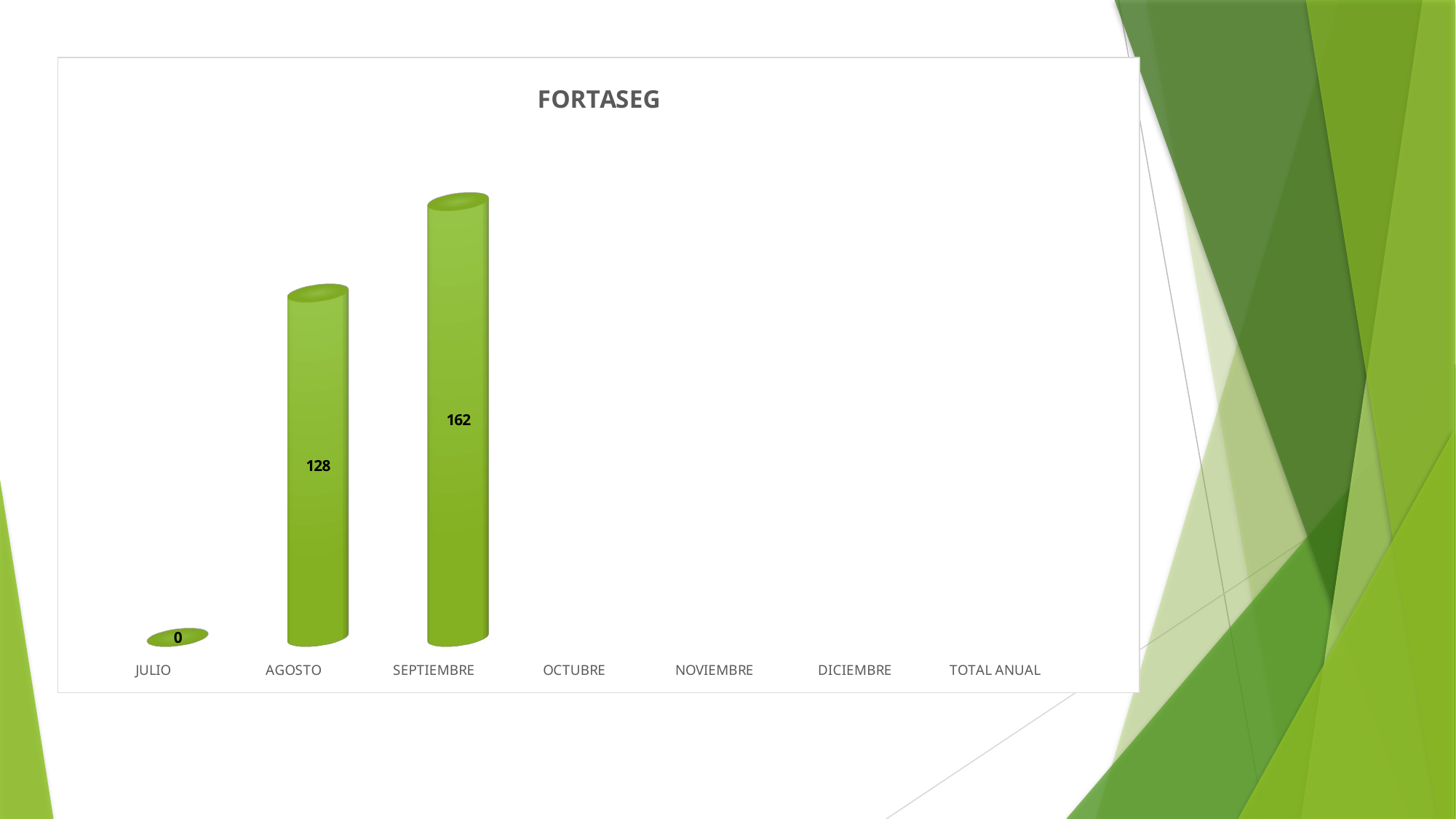
How many categories are shown on the x axis? 7 What colour are the bars in the chart? green Which category has the highest value? SEPTIEMBRE What is the label of the last category on the x axis? TOTAL ANUAL What is the value for AGOSTO? 128 What is the title of the chart? FORTASEG What is the value for JULIO? 0 What is the value for SEPTIEMBRE? 162 Which is larger, the value for AGOSTO or the value for SEPTIEMBRE? SEPTIEMBRE What is the difference between the values for SEPTIEMBRE and AGOSTO? 34 What kind of chart is this? bar chart Do the values rise or fall from JULIO to SEPTIEMBRE? rise